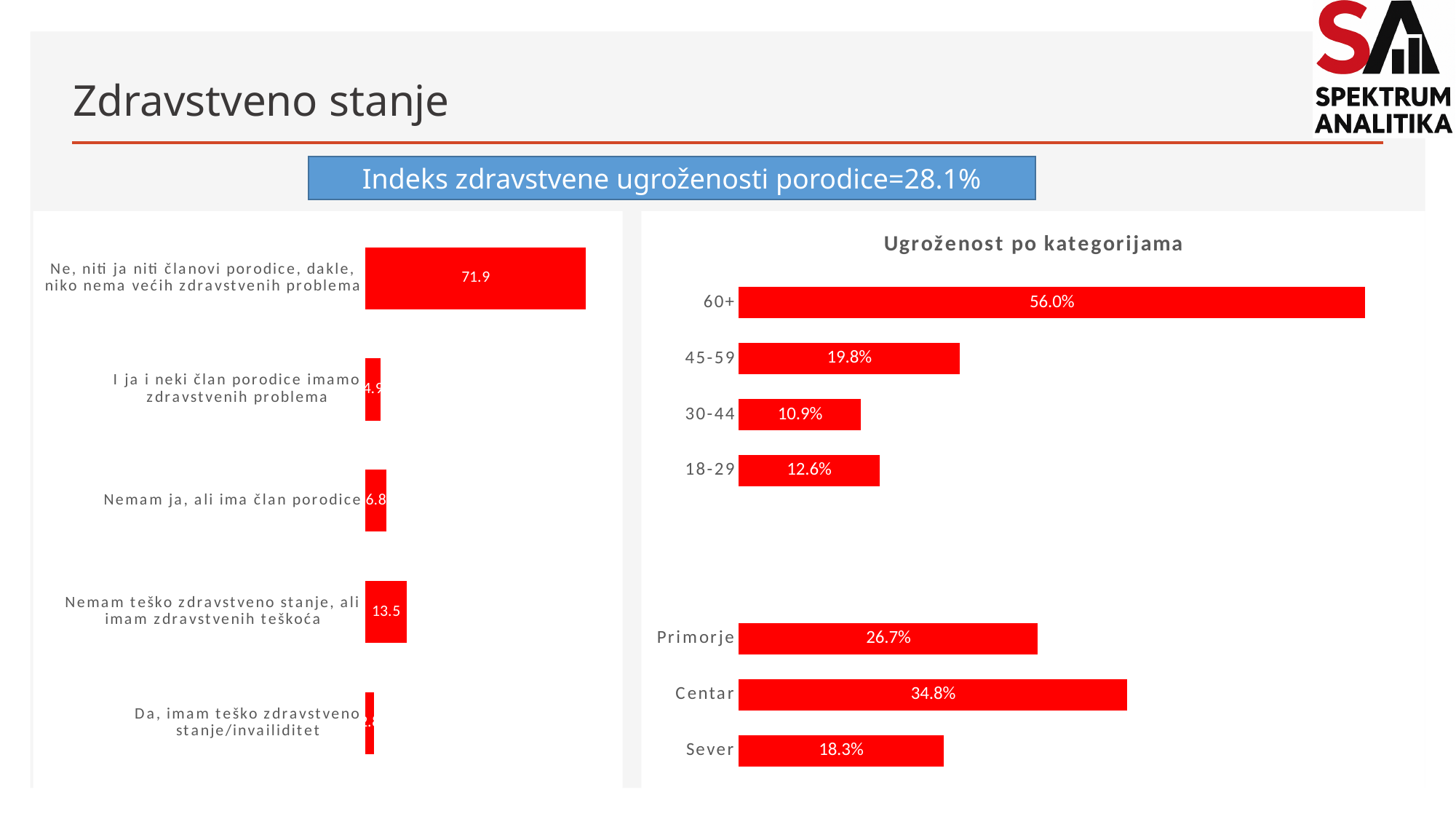
In the chart titled 'Ugroženost po kategorijama', what is the value for the 30-44 age group? 10.9% In the chart on the left side of the slide, what is the value for 'Nemam teško zdravstveno stanje, ali imam zdravstvenih teškoća'? 13.5 In the chart titled 'Ugroženost po kategorijama', which of the three regions (Primorje, Centar, Sever) has the lowest value? Sever In the chart titled 'Ugroženost po kategorijama', what is the value for Centar? 34.8% What kind of chart is the chart titled 'Ugroženost po kategorijama'? Bar chart In the chart titled 'Ugroženost po kategorijama', which category has the highest value? 60+ In the chart titled 'Ugroženost po kategorijama', how many categories are plotted? 7 In the chart on the left side of the slide, which category has the highest value? Ne, niti ja niti članovi porodice, dakle, niko nema većih zdravstvenih problema In the chart on the left side of the slide, what is the value for 'Ne, niti ja niti članovi porodice, dakle, niko nema većih zdravstvenih problema'? 71.9 In the chart titled 'Ugroženost po kategorijama', what is the difference between the values for Centar and Primorje? 8.1% In the chart titled 'Ugroženost po kategorijama', which is larger, the value for 18-29 or the value for 30-44? 18-29 In the chart titled 'Ugroženost po kategorijama', what is the value for the 60+ age group? 56.0%